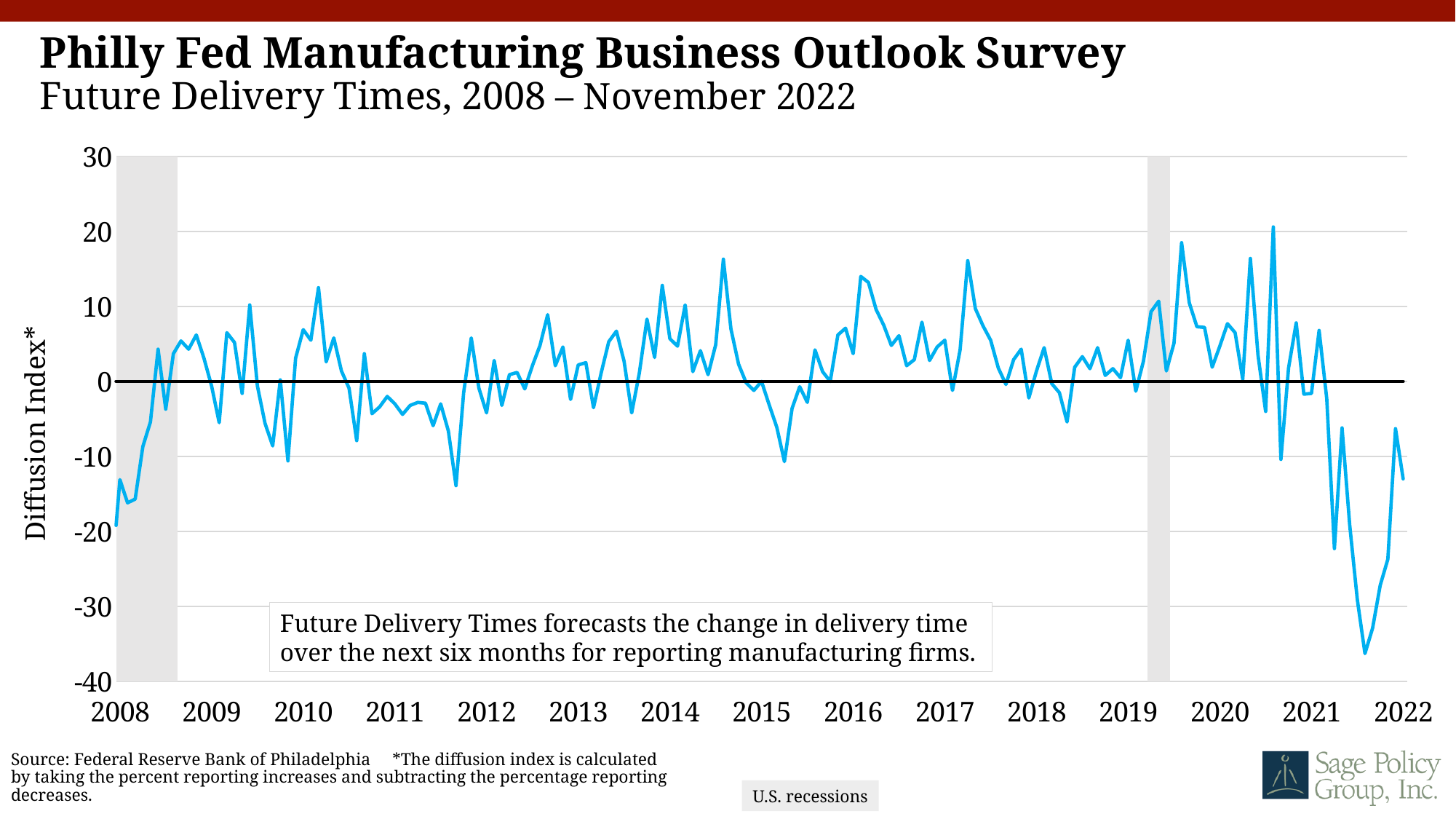
Is the final value plotted (November 2022) greater or less than 0? less Is the value at the start of 2020 greater or less than 10? less What kind of chart is shown on the slide? Line chart From the start of 2021 to the low point later in 2021, does the line rise or fall? fall Is the highest value on the chart greater or less than 15? greater What do the grey shaded areas on the chart represent? U.S. recessions How many grey recession bands are shaded on the chart? 2 What is the label on the vertical axis of the chart? Diffusion Index*